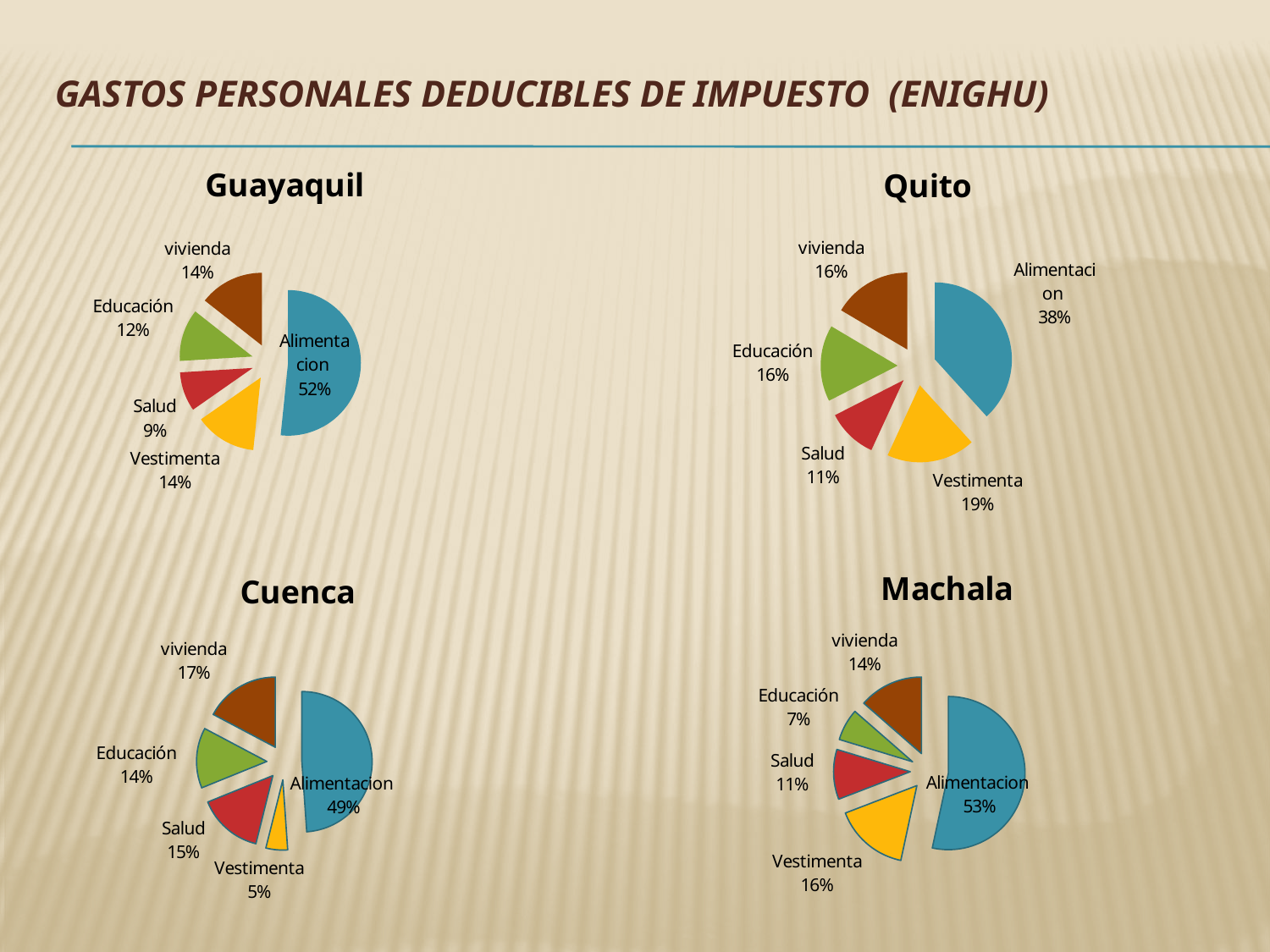
In the Quito chart, which is larger, the share for Educación or the share for Salud? Educación What kind of chart is the Machala chart? Pie chart In the Guayaquil chart, which category has the smallest share? Salud How many categories does the Cuenca chart show? 5 How many pie charts are on the slide? 4 In the Machala chart, what is the difference between the Alimentacion share and the Vestimenta share? 37% In the Cuenca chart, which category has the smallest share? Vestimenta In the Quito chart, which category has the largest share? Alimentacion In the Machala chart, what share does Educación have? 7% In the Guayaquil chart, what share does Alimentacion have? 52% In the Quito chart, what share does Vestimenta have? 19% In the Cuenca chart, what share does Vestimenta have? 5%